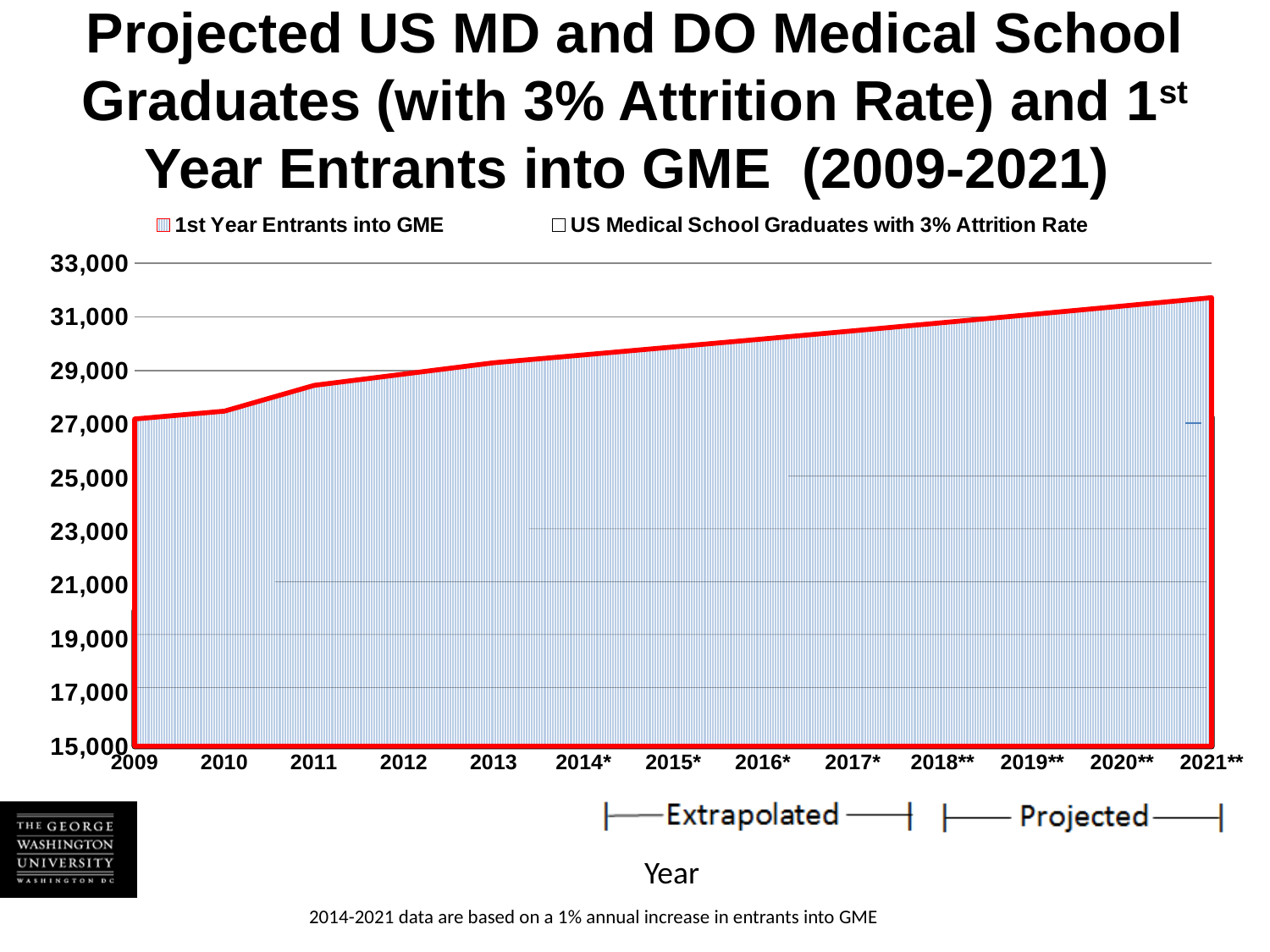
Which year has the highest plotted value on the chart? 2021** What is the title of the x axis of the chart? Year How many years are shown along the x axis of the chart? 13 Which year has the lowest plotted value on the chart? 2009 Is the plotted value for 2011 greater or less than 29,000? less What kind of chart is shown on the slide? area chart Is the plotted value for 2021** greater or less than 31,000? greater Is the plotted value for 2010 greater or less than 29,000? less What is the first series listed in the chart legend? 1st Year Entrants into GME How many series does the chart legend list? 2 Do the plotted values rise or fall from 2009 to 2021**? rise